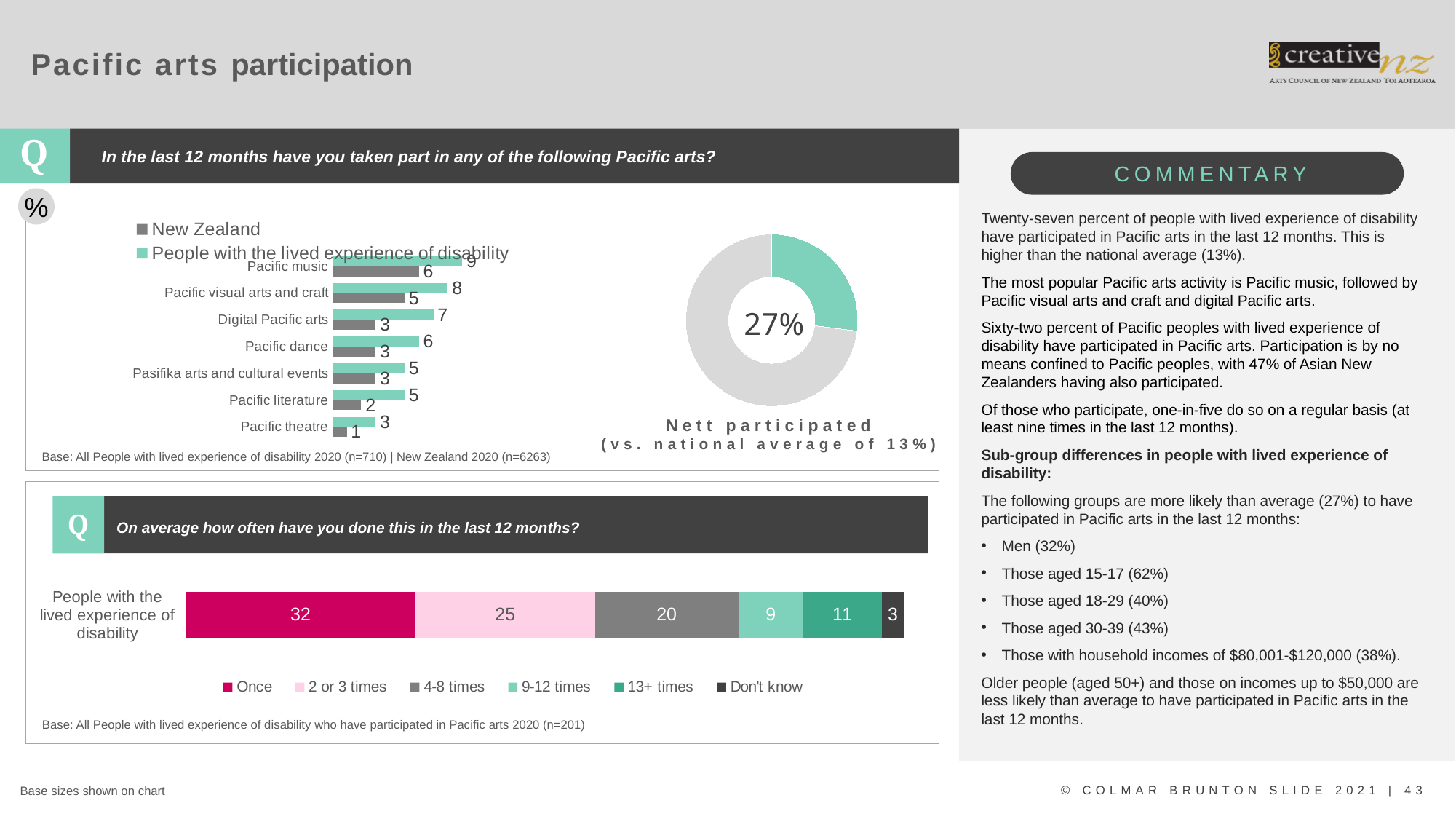
In the bar chart of Pacific arts activities, how many series does the legend list? 2 In the bar chart of Pacific arts activities, what is the difference between the People with the lived experience of disability value and the New Zealand value for Pacific visual arts and craft? 3 In the bar chart of Pacific arts activities, which activity has the lowest New Zealand value? Pacific theatre In the bar chart of Pacific arts activities, what is the value for People with the lived experience of disability for Pacific music? 9 What percentage is shown in the centre of the donut chart labelled Nett participated? 27% In the stacked bar chart about how often people have done this in the last 12 months, what is the value for Once? 32 In the stacked bar chart about how often people have done this in the last 12 months, which segment is larger: 9-12 times or 13+ times? 13+ times In the stacked bar chart about how often people have done this in the last 12 months, how many series does the legend list? 6 In the bar chart of Pacific arts activities, how many activities are listed? 7 In the bar chart of Pacific arts activities, which activity has the highest value for People with the lived experience of disability? Pacific music In the stacked bar chart about how often people have done this in the last 12 months, what is the total of all segments? 100 In the bar chart of Pacific arts activities, what is the New Zealand value for Digital Pacific arts? 3